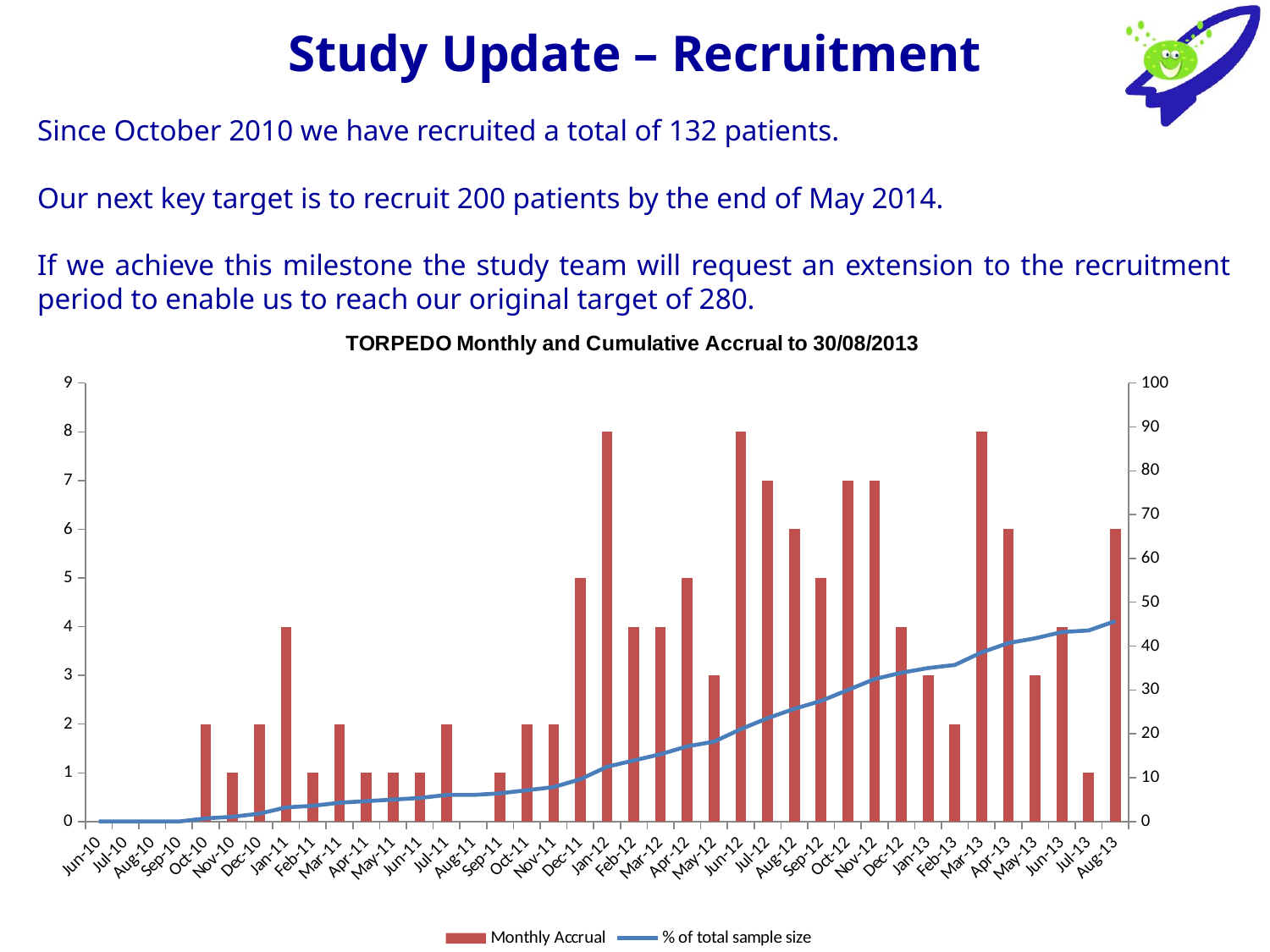
Which month has the larger Monthly Accrual, Dec-11 or Feb-13? Dec-11 How many series does the chart legend list? 2 What is the Monthly Accrual value for Jul-12? 7 What is the Monthly Accrual value for Jan-12? 8 What is the Monthly Accrual value for Jan-11? 4 Is the % of total sample size value for Aug-13 greater or less than 40? greater What is the difference between the Monthly Accrual for Jun-12 and for May-12? 5 What is the highest Monthly Accrual value reached in any month on the chart? 8 How many months are shown on the x axis of the chart? 39 What is the Monthly Accrual value for Aug-13? 6 Which series is shown as a line in the chart? % of total sample size What is the title of the chart? TORPEDO Monthly and Cumulative Accrual to 30/08/2013